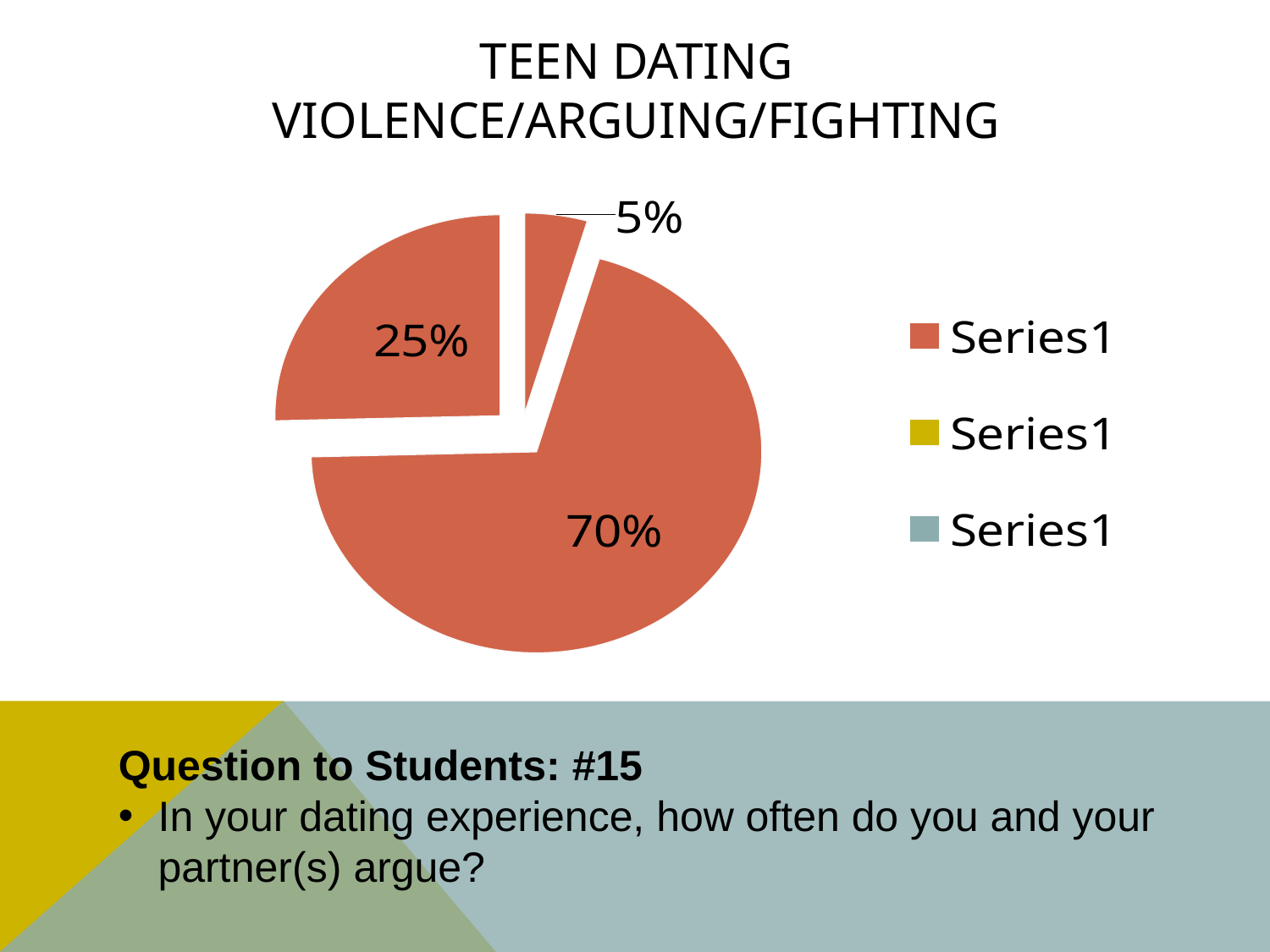
How many entries does the legend list? 3 What is the difference between the 70% slice and the 25% slice? 45% What is the title of the chart? TEEN DATING VIOLENCE/ARGUING/FIGHTING What label is shown for each entry in the legend? Series1 What is the total of the three slice values shown on the pie chart? 100% What is the value of the smallest slice in the pie chart? 5% What is the difference between the largest slice and the smallest slice in the pie chart? 65% How many slices does the pie chart have? 3 Which is larger, the slice labelled 25% or the slice labelled 5%? 25% What kind of chart is shown on the slide? pie chart What is the value of the largest slice in the pie chart? 70%